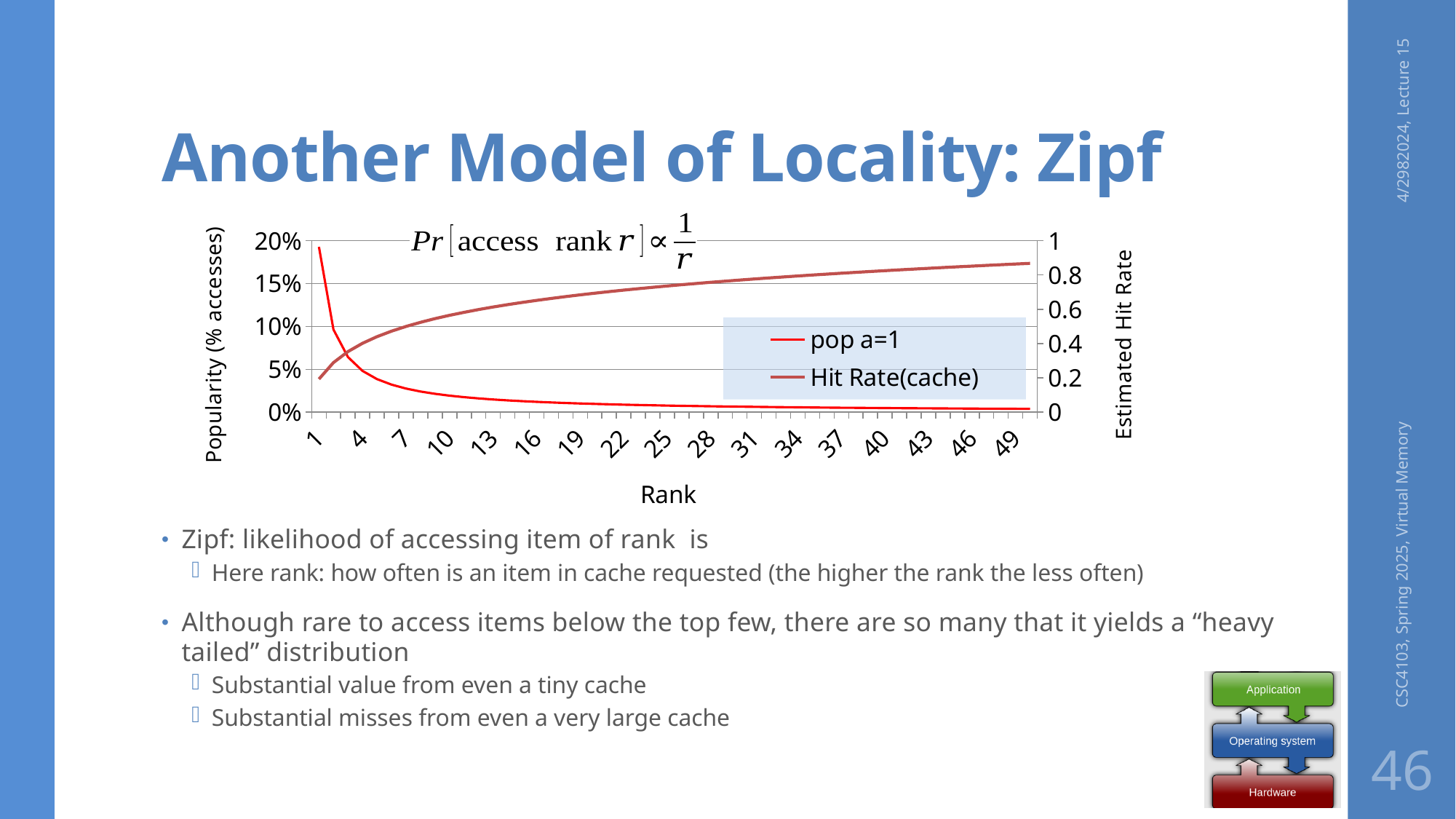
Is the value of Hit Rate(cache) at rank 25 greater or less than 0.6? greater At which rank is the Hit Rate(cache) series lowest? 1 Does the Hit Rate(cache) series rise or fall as rank increases? rise What are the two series named in the chart's legend? pop a=1 and Hit Rate(cache) At which rank is the pop a=1 series highest? 1 Does the pop a=1 series rise or fall as rank increases? fall What is the title of the chart's x axis? Rank How many series does the chart's legend list? 2 Is the value of Hit Rate(cache) at rank 49 greater or less than 0.8? greater Is the value of pop a=1 at rank 10 greater or less than 5%? less What kind of chart is shown on the slide? line chart